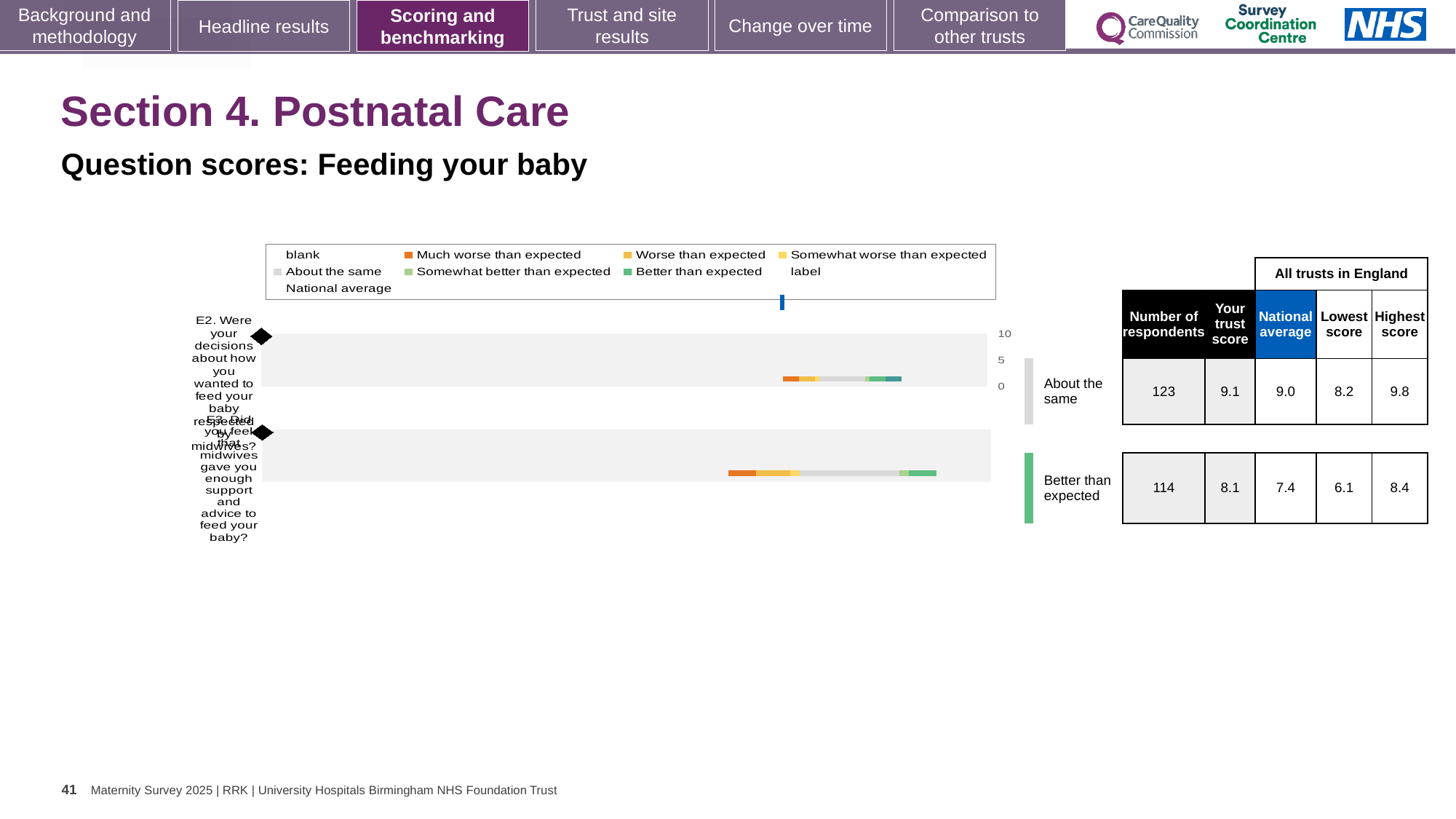
By how much does the trust score for E2 exceed the national average for E2? 0.1 What kind of chart is shown on the slide for the feeding your baby question scores? bar chart How many respondents answered question E2? 123 What is the 'Your trust score' for E2 (decisions about how you wanted to feed your baby respected by midwives)? 9.1 What is the highest score among all trusts in England for E3? 8.4 How many more respondents answered E2 than E3? 9 Which question has the higher 'Your trust score', E2 or E3? E2 By how much does the trust score for E3 exceed the national average for E3? 0.7 What is the national average for E3 (midwives gave you enough support and advice to feed your baby)? 7.4 Which benchmark category is shown for question E3? Better than expected How many questions (categories) are plotted in the chart? 2 What is the lowest score among all trusts in England for E2? 8.2